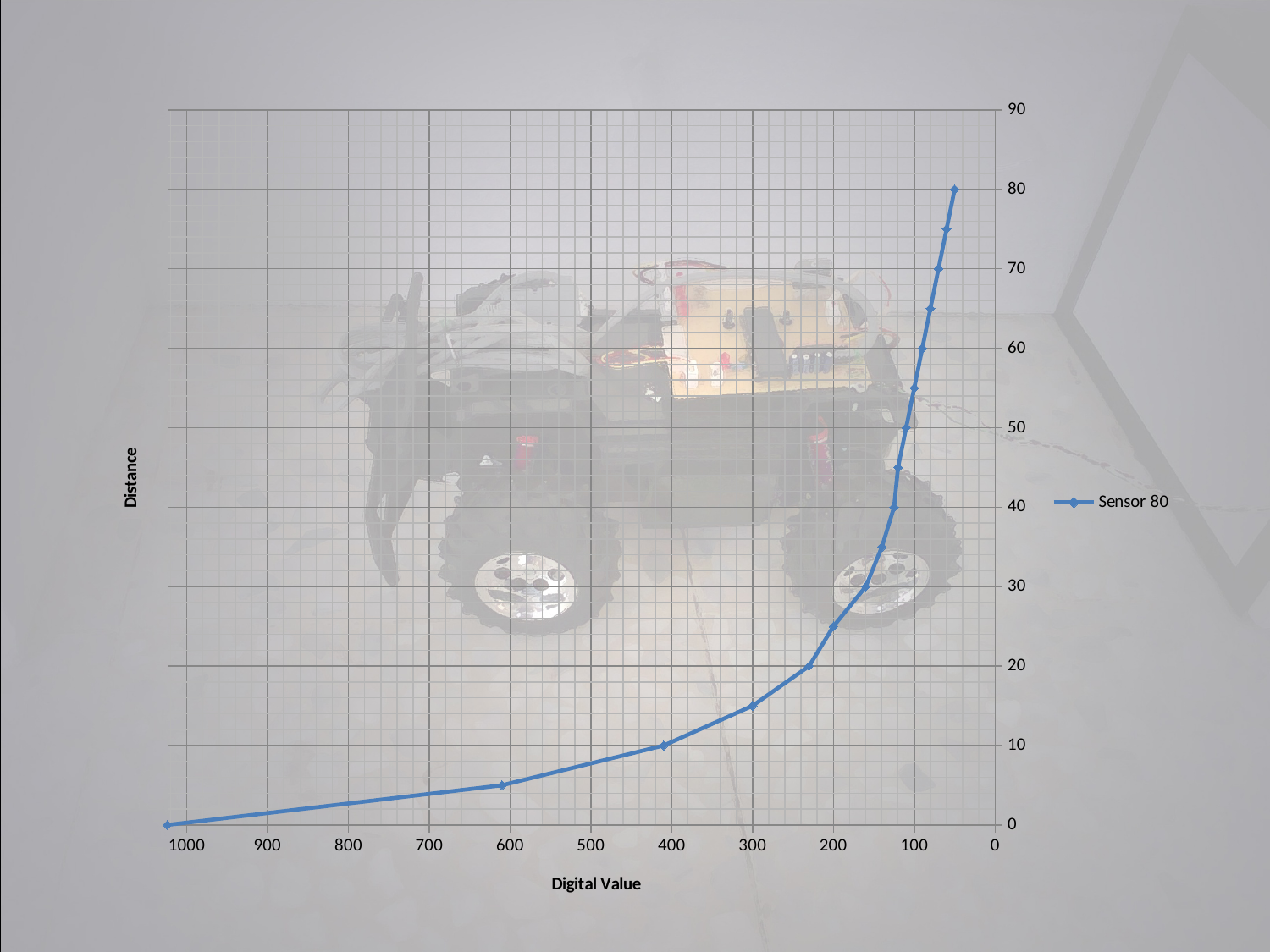
What is the title of the horizontal axis? Digital Value Is the Distance at a Digital Value of 100 greater or less than 50? greater What is the highest Distance value reached by the Sensor 80 line? 80 What is the lowest Distance value on the Sensor 80 line? 0 What is the name of the series shown in the legend? Sensor 80 Is the Distance at a Digital Value of 600 greater or less than 10? less Which is larger, the Distance at a Digital Value of 200 or at a Digital Value of 400? 200 Is the Distance at a Digital Value of 300 greater or less than 20? less How many data points are plotted on the Sensor 80 line? 17 What type of chart is shown on the slide? line chart How many series does the legend list? 1 Does the Distance rise or fall as you move from left to right along the x axis? rise